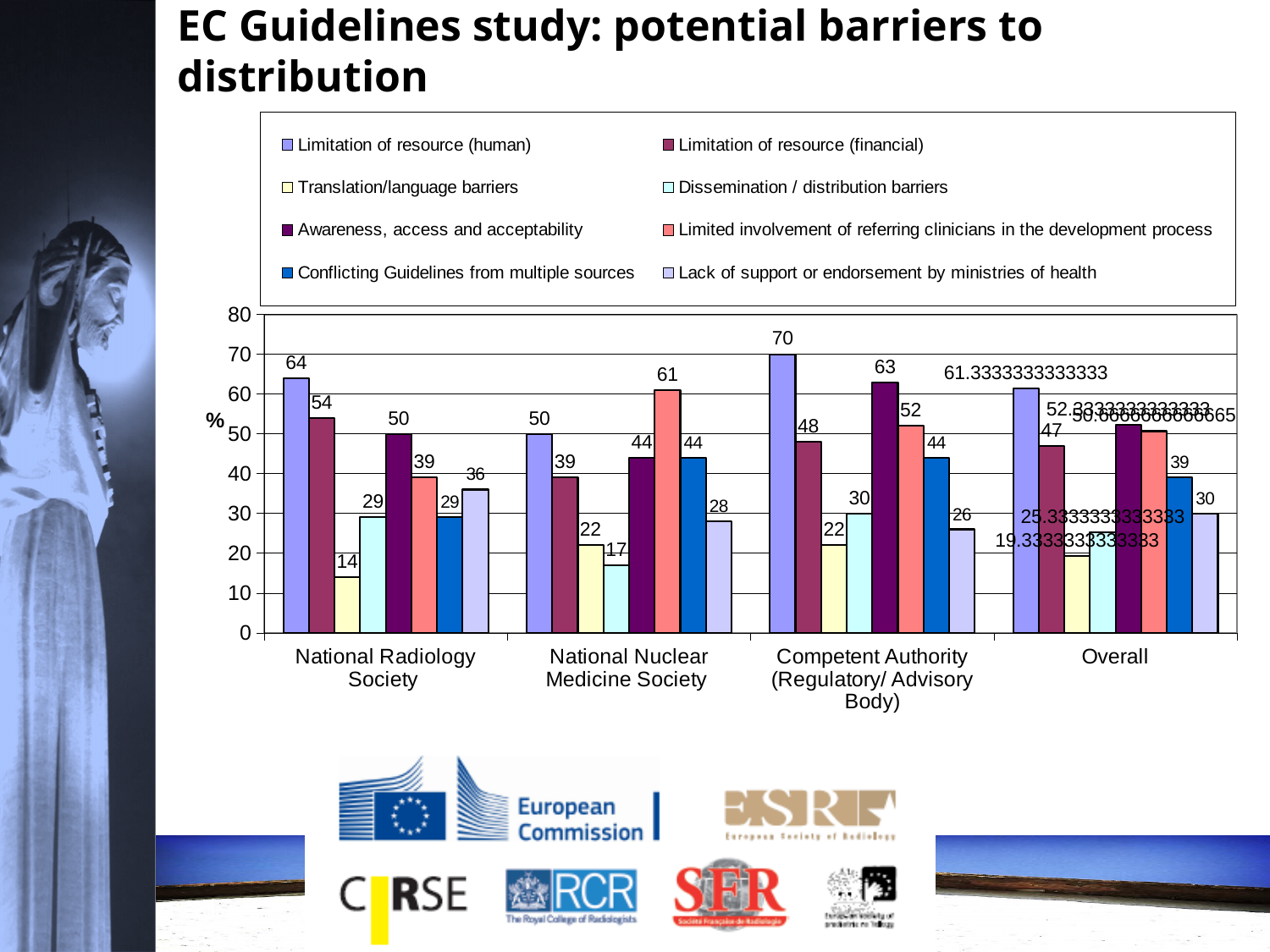
For the Competent Authority (Regulatory/ Advisory Body), what is the difference between Limitation of resource (human) and Limitation of resource (financial)? 22 How many series does the legend list? 8 Is the value for Limitation of resource (human) in the Overall category greater or less than 60? greater Which barrier has the highest value for the Competent Authority (Regulatory/ Advisory Body)? Limitation of resource (human) What is the value for Limitation of resource (human) for the National Radiology Society? 64 For the National Radiology Society, which is larger: Awareness, access and acceptability or Limited involvement of referring clinicians in the development process? Awareness, access and acceptability Which barrier has the lowest value for the National Radiology Society? Translation/language barriers What is the value for Dissemination / distribution barriers for the National Nuclear Medicine Society? 17 What is the value for Limited involvement of referring clinicians in the development process for the National Nuclear Medicine Society? 61 How many respondent categories are shown along the x axis? 4 What kind of chart is shown on the slide? bar chart What is the value for Conflicting Guidelines from multiple sources in the Overall category? 39